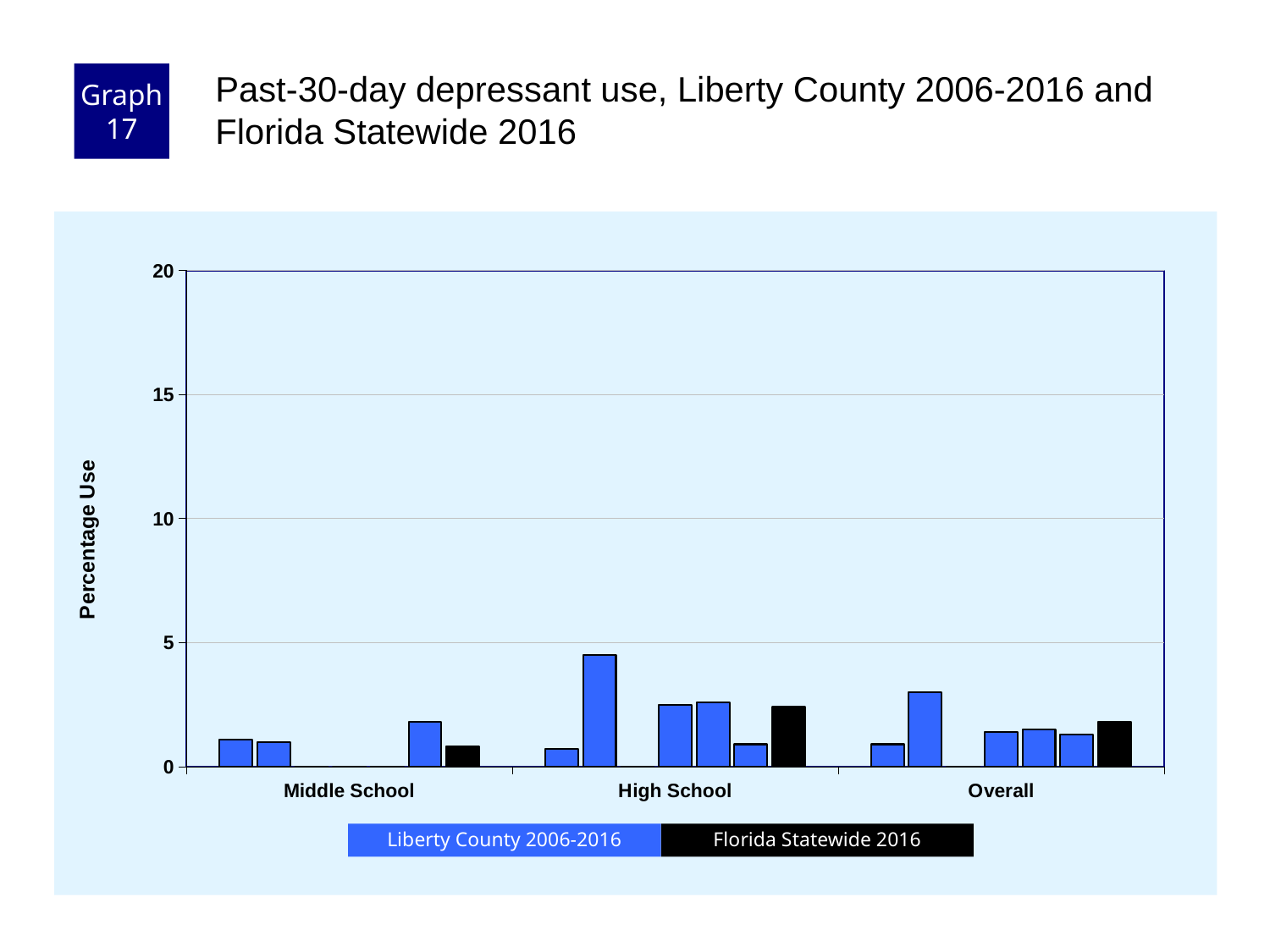
What is the label on the y axis? Percentage Use Is the tallest Liberty County 2006-2016 bar in the High School group greater or less than 5? less In which category is the Florida Statewide 2016 value the highest? High School What colour are the Florida Statewide 2016 bars? black Which is larger, the Florida Statewide 2016 value for Overall or for Middle School? Overall Is the Florida Statewide 2016 value for High School greater or less than 5? less How many categories are shown on the x axis? 3 How many series does the legend list? 2 What kind of chart is shown on the slide? bar chart In which category is the Florida Statewide 2016 value the lowest? Middle School Is the Florida Statewide 2016 value for Middle School greater or less than 5? less